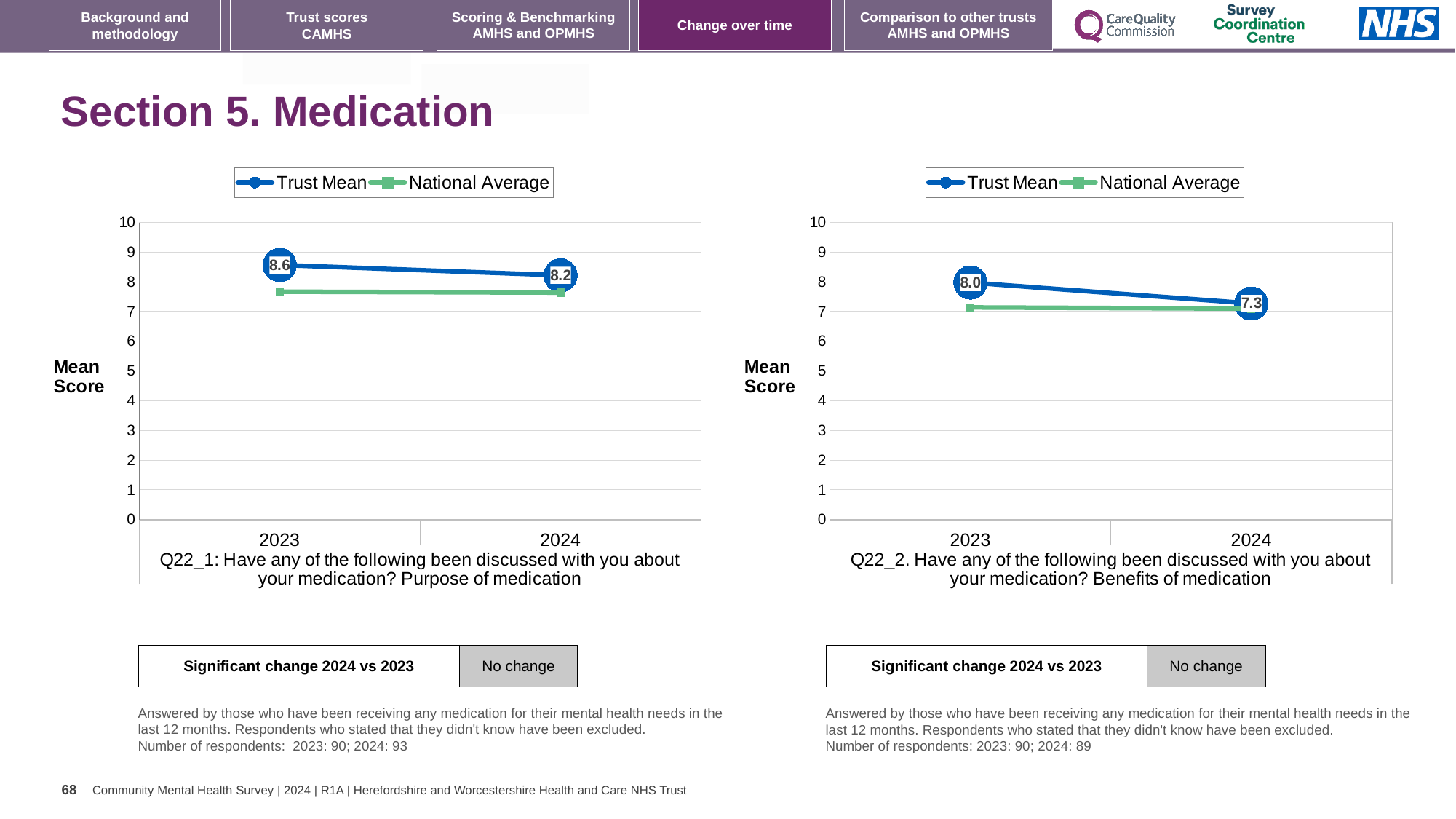
In the left chart (Q22_1: Purpose of medication), what is the Trust Mean score for 2023? 8.6 In the left chart (Q22_1: Purpose of medication), what is the Trust Mean score for 2024? 8.2 How many years are plotted on the x axis of the right chart (Q22_2)? 2 How many series does the legend of the left chart (Q22_1) list? 2 In the left chart (Q22_1: Purpose of medication), is the National Average for 2023 greater or less than 8? less What type of chart is used on this slide? line chart In the left chart (Q22_1: Purpose of medication), which is higher in 2023, the Trust Mean or the National Average? Trust Mean In the right chart (Q22_2: Benefits of medication), does the Trust Mean rise or fall from 2023 to 2024? fall In the right chart (Q22_2: Benefits of medication), what is the Trust Mean score for 2023? 8.0 In the right chart (Q22_2: Benefits of medication), what is the difference between the Trust Mean in 2023 and 2024? 0.7 In the right chart (Q22_2: Benefits of medication), what is the Trust Mean score for 2024? 7.3 In the left chart (Q22_1: Purpose of medication), by how much did the Trust Mean change from 2023 to 2024? 0.4